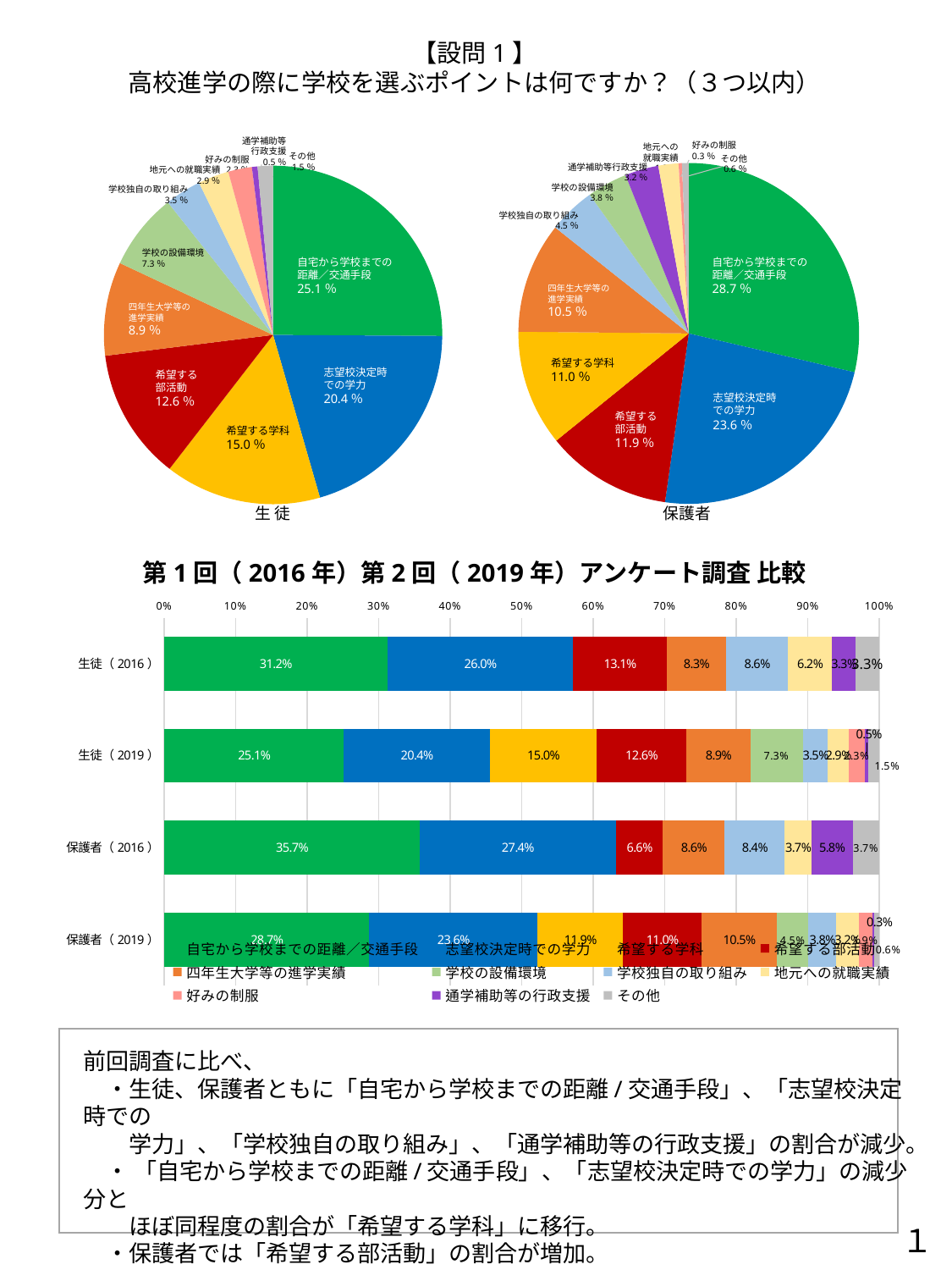
How many bars (rows) are shown in the bottom stacked bar chart? 4 In the bottom stacked bar chart, what is the value of the first (green) segment for 生徒（2016）? 31.2% In the bottom stacked bar chart, what is the value of the first (green) segment for 保護者（2016）? 35.7% In the 生徒 pie chart, what is the difference between 希望する学科 and 希望する部活動? 2.4% What type of chart is the bottom chart comparing 2016 and 2019? Stacked bar chart In the 保護者 pie chart, what percentage is shown for 志望校決定時での学力? 23.6% In the 生徒 pie chart, which category has the largest share? 自宅から学校までの距離／交通手段 In the 保護者 pie chart, which is larger: 希望する部活動 or 希望する学科? 希望する部活動 In the 生徒 pie chart, what percentage is shown for 自宅から学校までの距離／交通手段? 25.1% In the 生徒 pie chart, which category has the smallest share? 通学補助等行政支援 In the 保護者 pie chart, what is the difference between 自宅から学校までの距離／交通手段 and 志望校決定時での学力? 5.1% How many entries does the legend of the bottom stacked bar chart list? 11